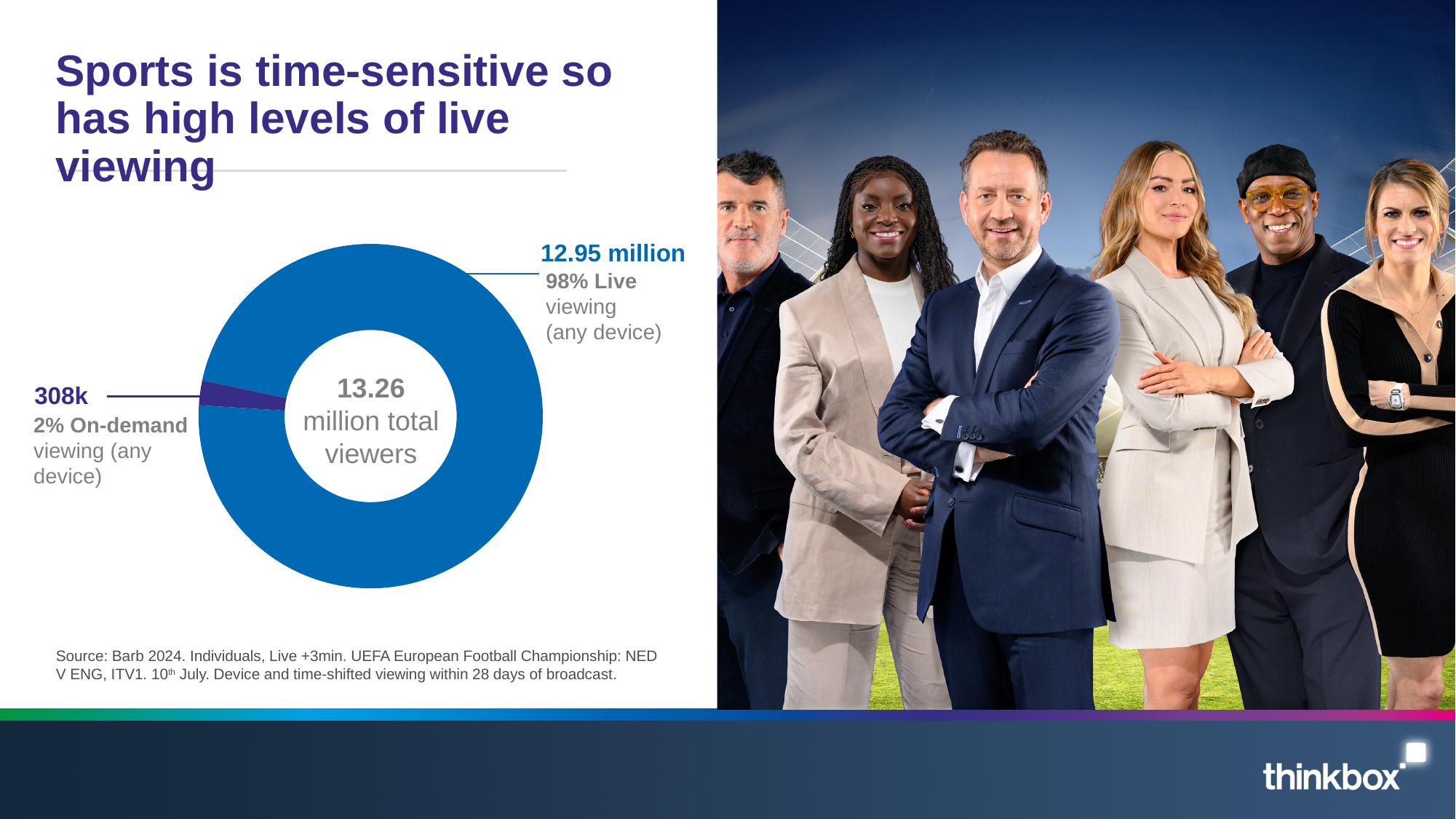
Which segment is the smallest in the donut chart? On-demand viewing (any device) What share of total viewers is On-demand viewing? 2% What kind of chart is shown on the slide? Donut (pie) chart What share of total viewers is Live viewing? 98% What is the total number of viewers shown in the centre of the donut chart? 13.26 million What is the value for On-demand viewing (any device)? 308k Which is larger, Live viewing or On-demand viewing? Live viewing Which segment is the largest in the donut chart? Live viewing (any device) How many segments does the donut chart have? 2 What is the value for Live viewing (any device)? 12.95 million What colour is the On-demand viewing segment of the donut chart? Purple What colour is the Live viewing segment of the donut chart? Blue